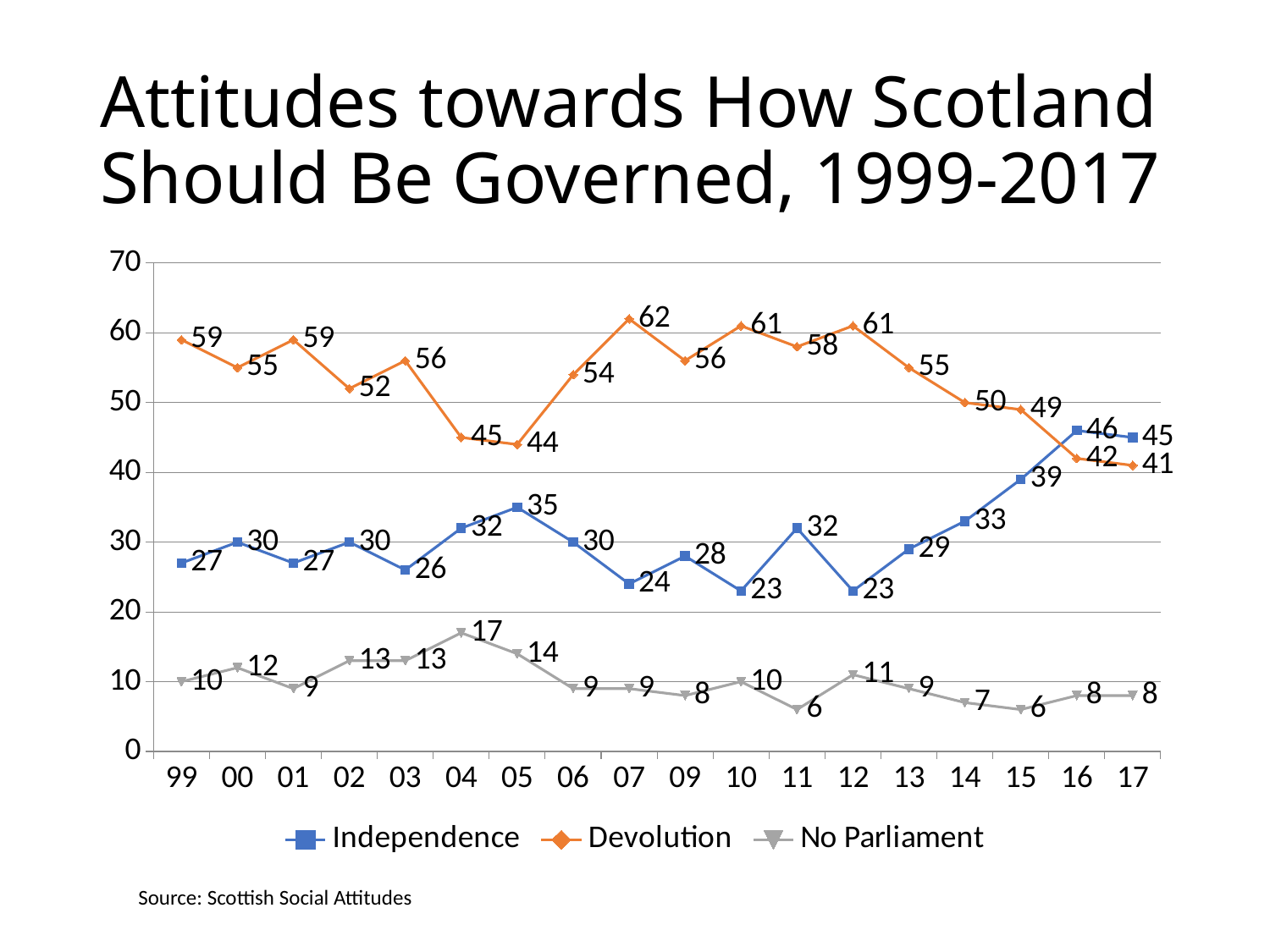
What type of chart is shown on the slide? line chart What is the value for Independence in 16? 46 What is the difference between the Devolution and Independence values in 99? 32 What is the title of the chart? Attitudes towards How Scotland Should Be Governed, 1999-2017 How many series does the legend list? 3 How many years are plotted along the x axis? 18 What is the value for Devolution in 07? 62 In which year does the Devolution series reach its lowest value? 17 What is the value for No Parliament in 04? 17 Which is larger in 17, Independence or Devolution? Independence Does the Devolution series rise or fall from 12 to 17? fall In which year does the Devolution series reach its highest value? 07